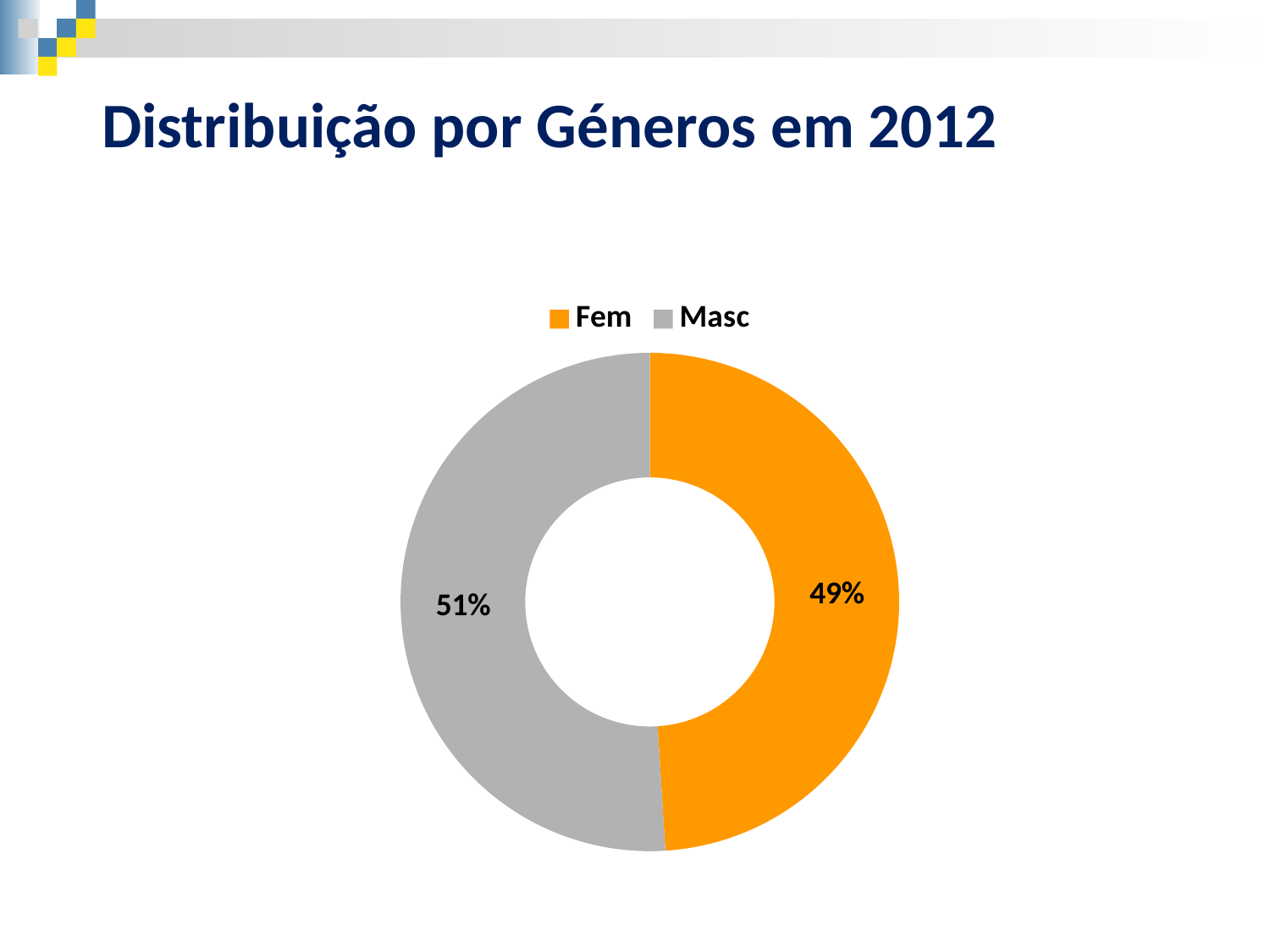
What share of the doughnut chart does Fem represent? 49% How many entries does the legend list? 2 What is the title of the slide? Distribuição por Géneros em 2012 What share of the doughnut chart does Masc represent? 51% What is the difference in percentage points between the Masc and Fem shares? 2 Which category has the largest share in the chart? Masc Which colour represents Fem in the chart? orange How many categories are shown in the chart? 2 Which category has the smallest share in the chart? Fem What kind of chart is shown on the slide? doughnut chart Which category has the larger share, Fem or Masc? Masc